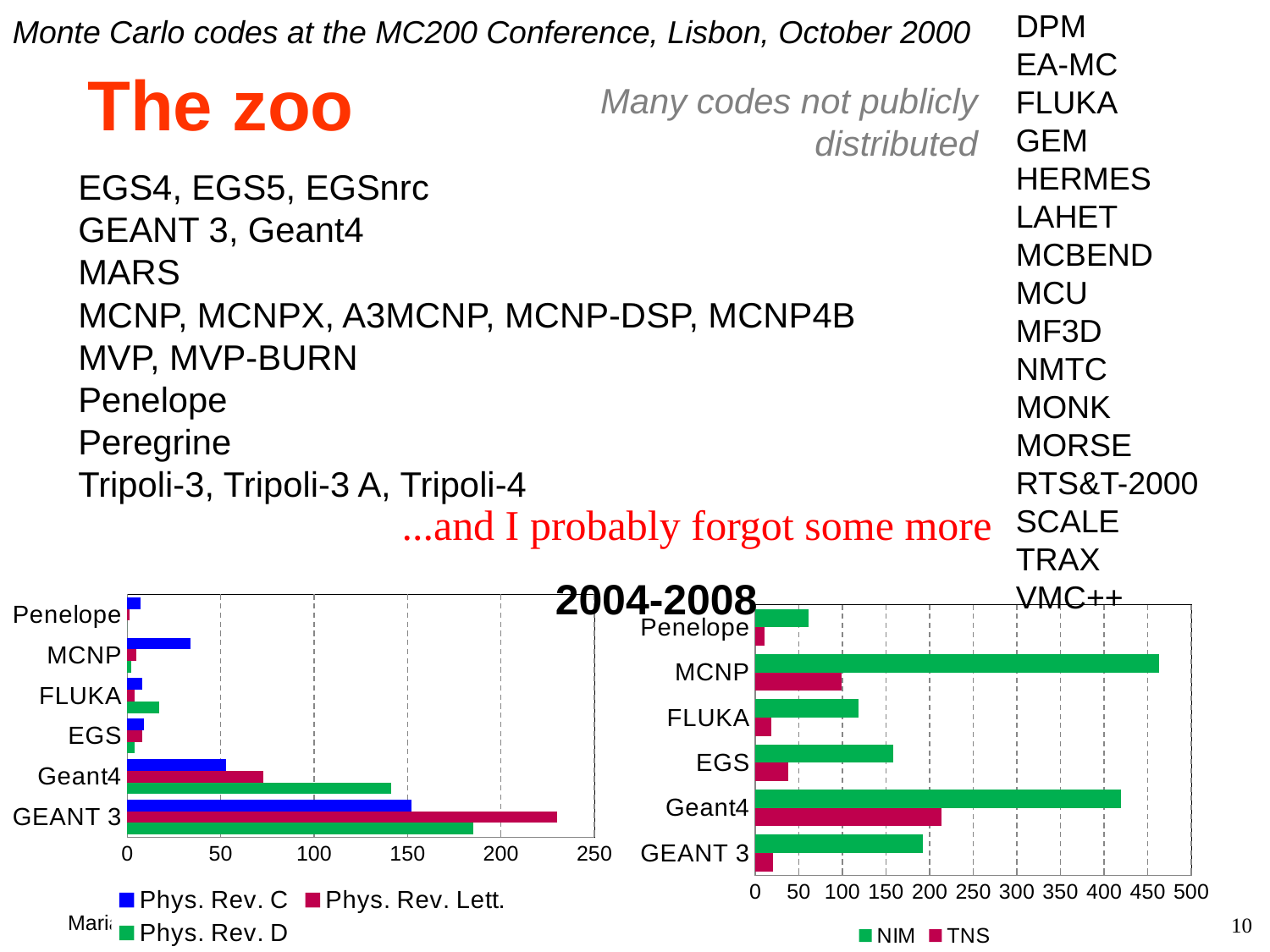
In the left-hand chart, which is larger for Geant4: the Phys. Rev. D value or the Phys. Rev. Lett. value? Phys. Rev. D In the right-hand chart (2004-2008), which code has the highest NIM value? MCNP In the right-hand chart (2004-2008), is the NIM value for Geant4 greater or less than 400? greater What kind of chart is the right-hand chart titled 2004-2008? bar chart What are the two legend entries of the right-hand chart (2004-2008)? NIM and TNS How many series does the legend of the left-hand chart list? 3 How many series does the legend of the right-hand chart (2004-2008) list? 2 In the left-hand chart, which code has the highest Phys. Rev. Lett. value? GEANT 3 In the left-hand chart, is the Phys. Rev. Lett. value for GEANT 3 greater or less than 200? greater In the right-hand chart (2004-2008), which code has the highest TNS value? Geant4 How many codes are listed on the category axis of the right-hand chart (2004-2008)? 6 In the right-hand chart (2004-2008), is the NIM value for GEANT 3 greater or less than 150? greater